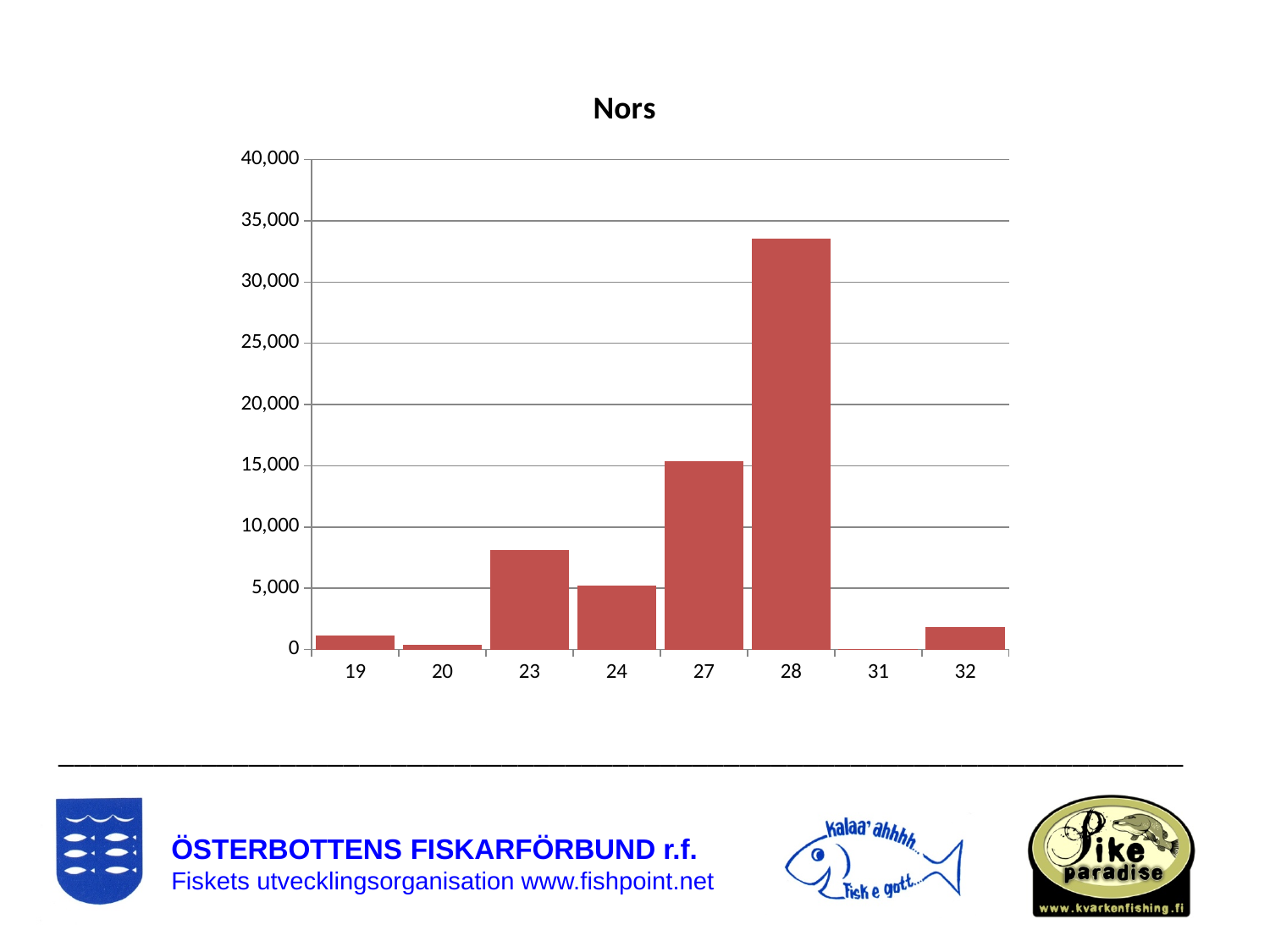
Is the value for 27 greater or less than 10,000? greater Which category has the lowest value in the chart? 31 Is the value for 28 greater or less than 30,000? greater Which has the larger value, 23 or 24? 23 Which category has the highest value in the chart? 28 Which has the larger value, 27 or 23? 27 Is the value for 32 greater or less than 5,000? less Which has the larger value, 32 or 20? 32 How many categories are shown on the x axis of the chart? 8 What is the title of the chart? Nors What kind of chart is shown on the slide? bar chart